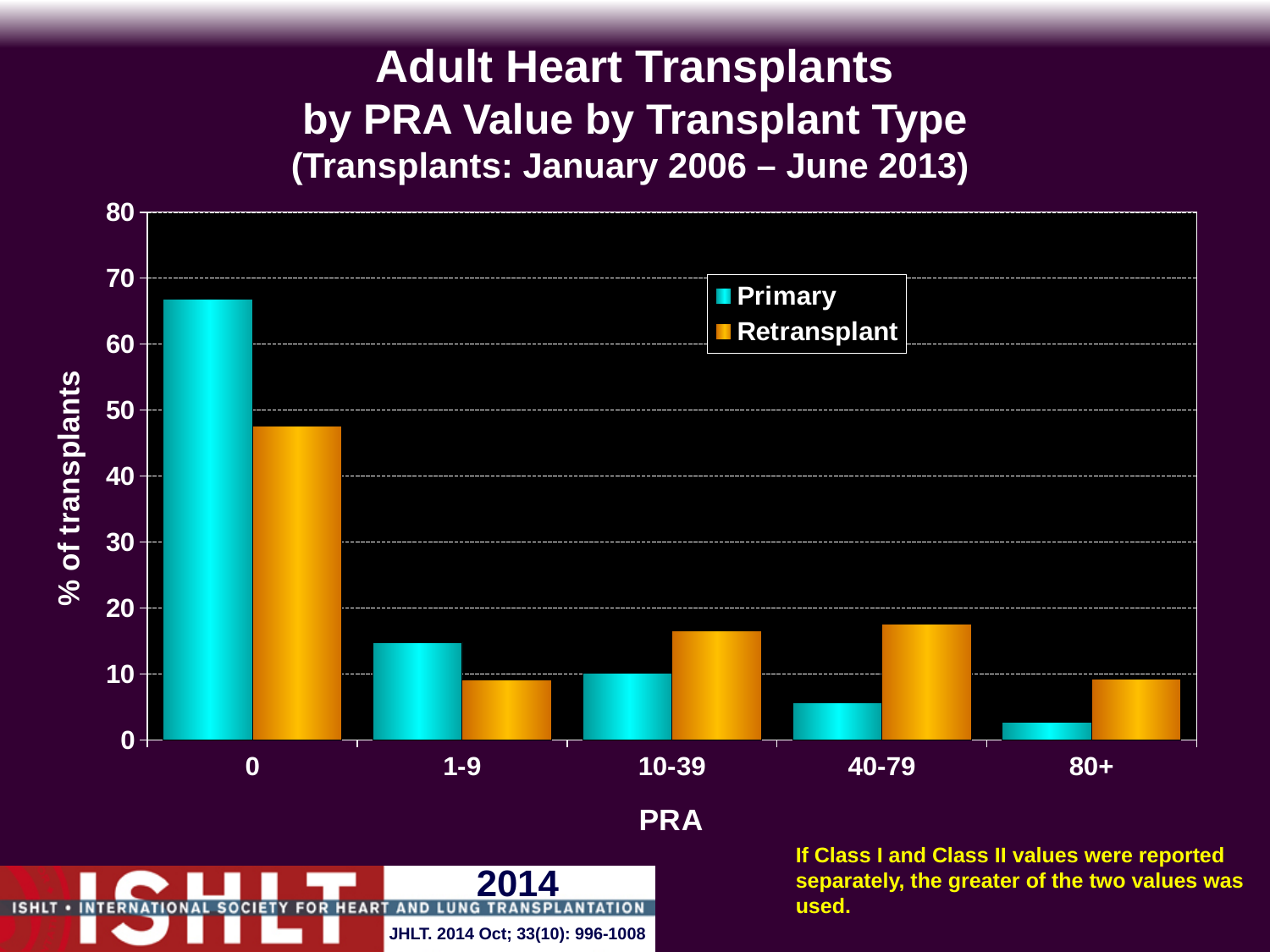
How many series does the legend list? 2 For which PRA category is the Primary value lowest? 80+ What kind of chart is shown on the slide? Bar chart Is the Retransplant value for PRA 0 greater or less than 50? less Is the Primary value for PRA 80+ greater or less than 10? less For which PRA category is the Primary value highest? 0 Is the Primary value for PRA 0 greater or less than 60? greater Do the Primary values rise or fall as PRA increases along the x axis? fall How many PRA categories are shown on the x axis? 5 For PRA 0, which series has the larger value, Primary or Retransplant? Primary For PRA 40-79, which series has the larger value, Primary or Retransplant? Retransplant